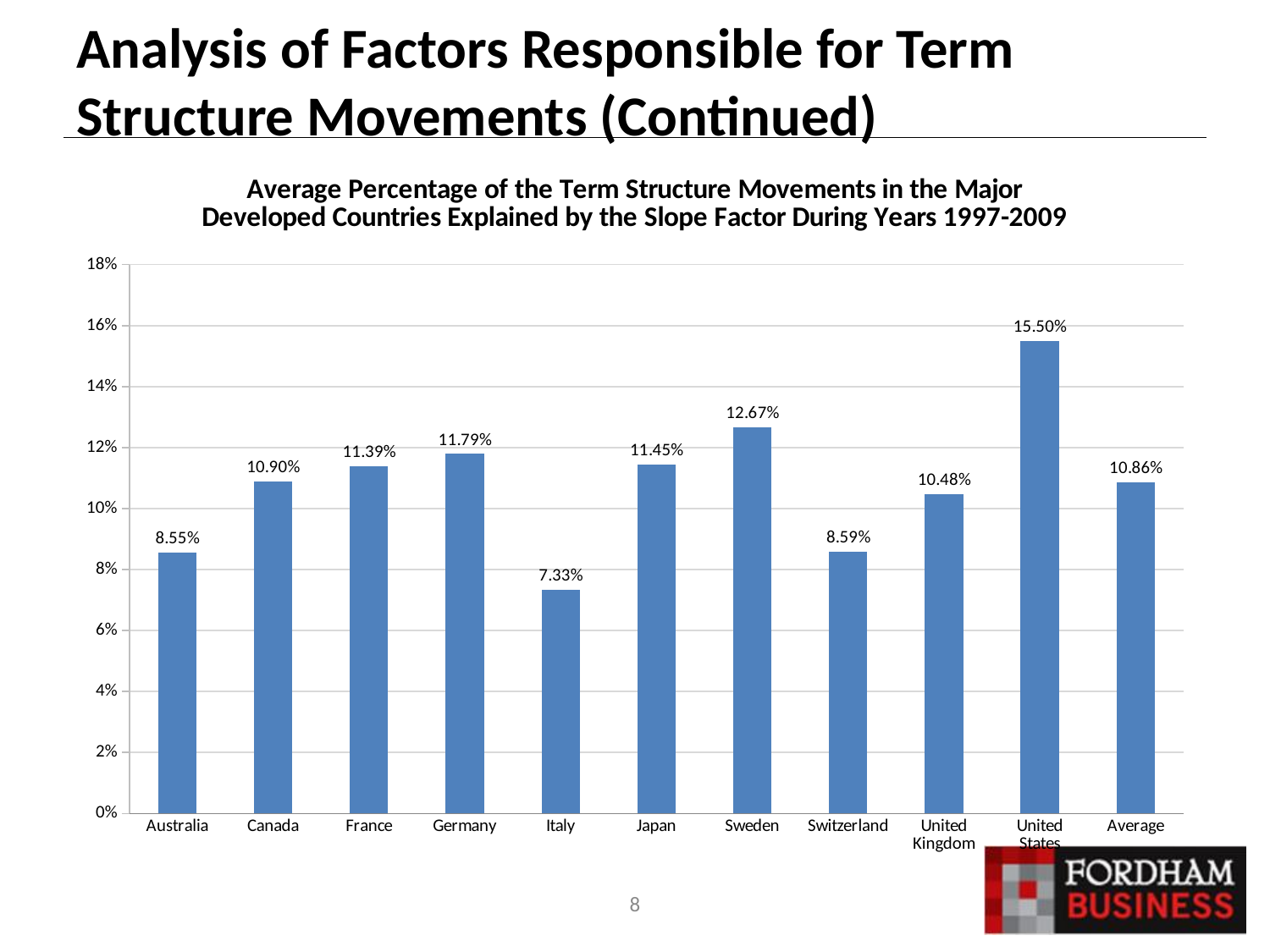
What is the value shown for Average? 10.86% Which category has the highest value? United States What is the value for the United Kingdom? 10.48% What is the value for Germany? 11.79% Which is larger, the value for Japan or the value for France? Japan Is the value for Switzerland greater or less than 10%? less What kind of chart is shown on the slide? bar chart How many categories are shown on the x axis? 11 What years does the chart title say the data covers? 1997-2009 What is the difference between the values for the United States and Italy? 8.17% What is the difference between the values for Sweden and Canada? 1.77% Which category has the lowest value? Italy